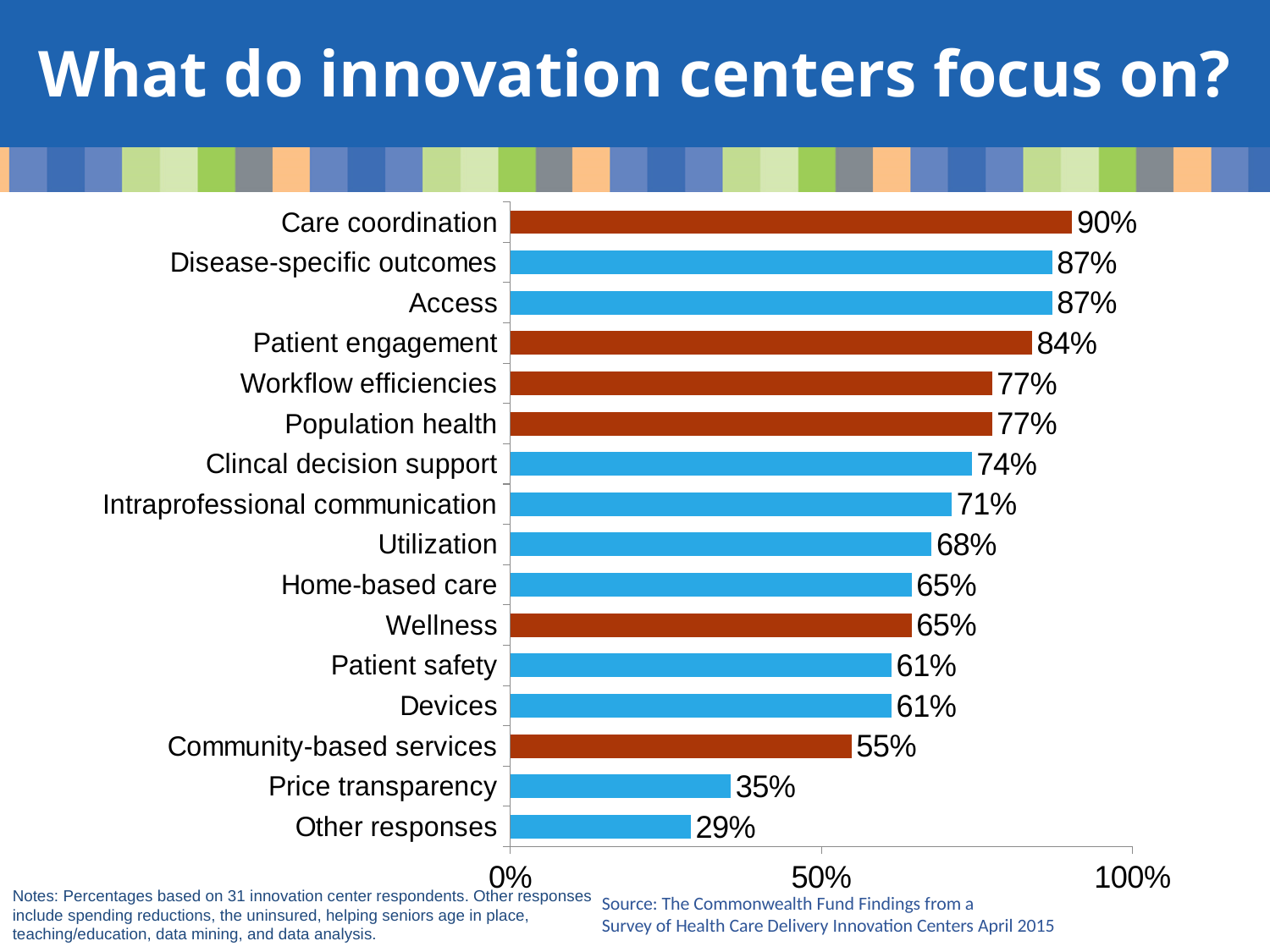
Which category has the highest value? Care coordination Which is larger, the value for Utilization or the value for Patient safety? Utilization What is the value for Price transparency? 35% What is the difference between the values for Patient engagement and Community-based services? 29% What is the difference between the values for Care coordination and Other responses? 61% What kind of chart is shown on the slide? Bar chart How many categories are shown in the chart? 16 What is the title of the slide? What do innovation centers focus on? Is the value for Community-based services greater or less than 50%? greater What is the value for Care coordination? 90% Which category has the lowest value? Other responses What is the value for Intraprofessional communication? 71%